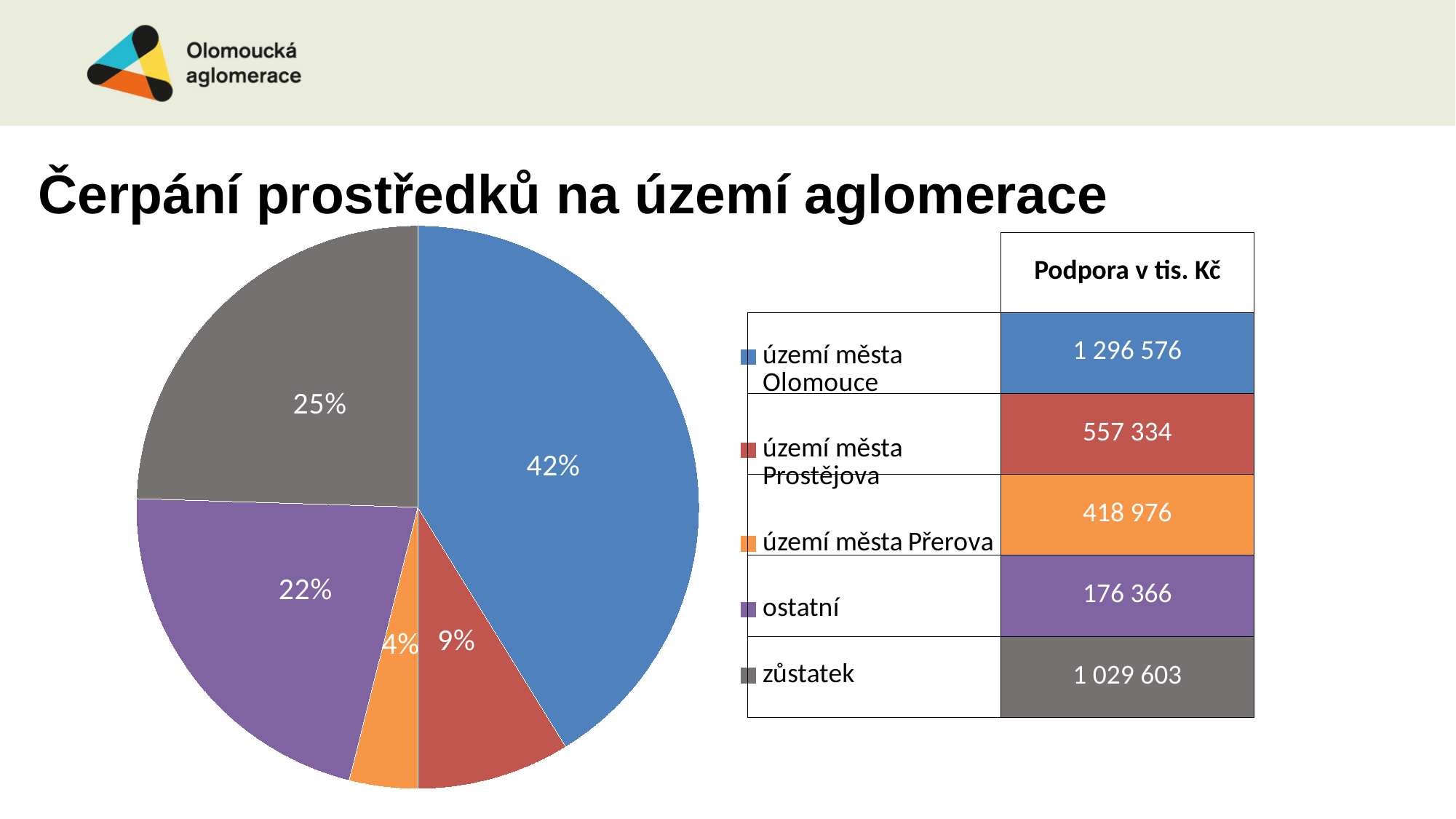
What is the difference in percentage points between the slices for území města Olomouce and zůstatek? 17 What share of the pie does území města Olomouce have? 42% Which slice is larger, zůstatek or ostatní? zůstatek What colour is the slice for ostatní? purple What share of the pie does zůstatek have? 25% How many categories does the pie chart have? 5 Which category has the largest slice of the pie? území města Olomouce What share of the pie does území města Prostějova have? 9% What kind of chart is shown on the slide? pie chart Which category has the smallest slice of the pie? území města Přerova